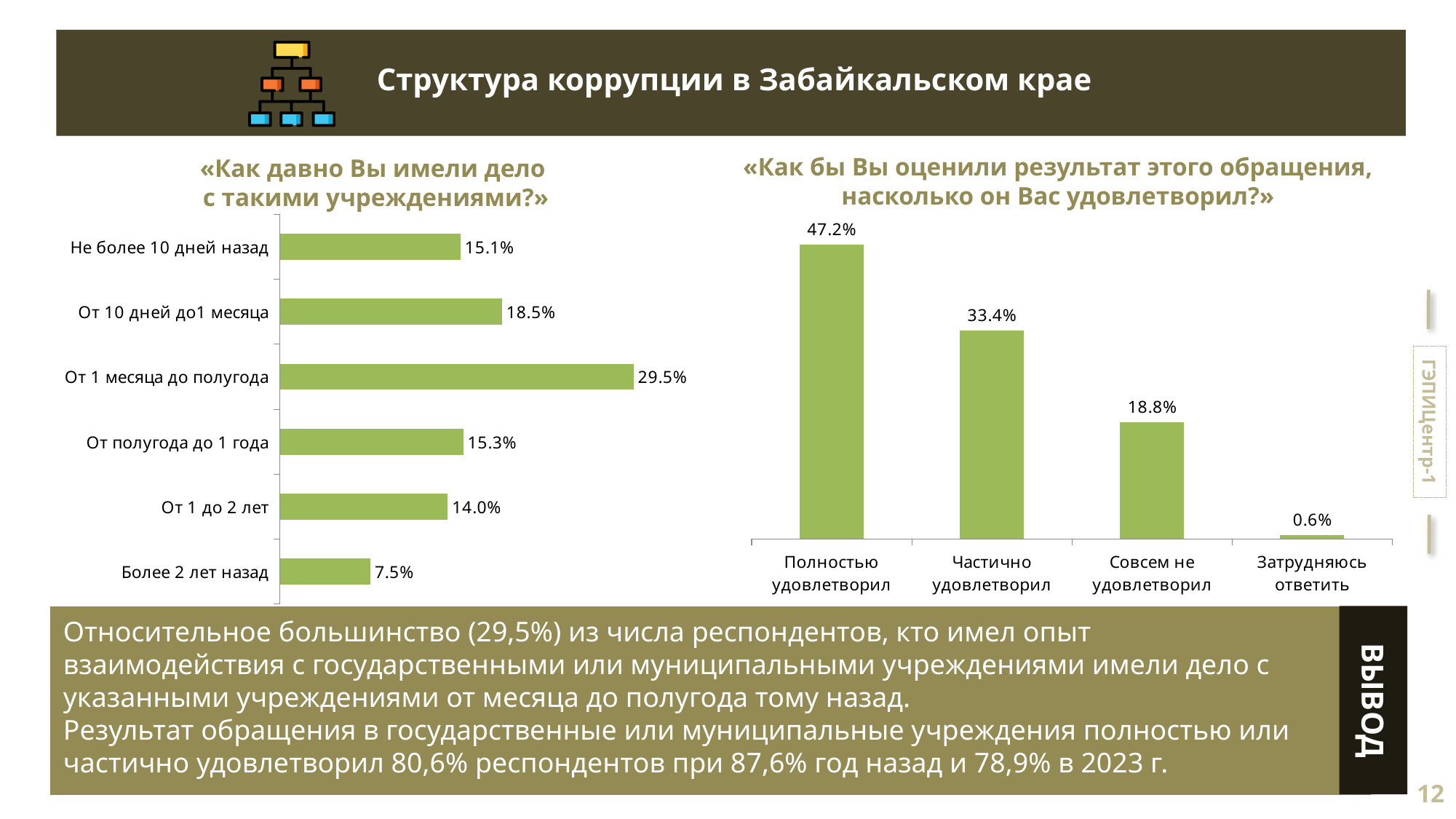
In the left chart «Как давно Вы имели дело с такими учреждениями?», how many categories are shown? 6 In the left chart «Как давно Вы имели дело с такими учреждениями?», what is the difference between «От 10 дней до1 месяца» and «Не более 10 дней назад»? 3.4% In the right chart «Как бы Вы оценили результат этого обращения, насколько он Вас удовлетворил?», do the values rise or fall from left to right? Fall In the right chart «Как бы Вы оценили результат этого обращения, насколько он Вас удовлетворил?», what is the value for «Затрудняюсь ответить»? 0.6% In the right chart «Как бы Вы оценили результат этого обращения, насколько он Вас удовлетворил?», what is the difference between «Полностью удовлетворил» and «Частично удовлетворил»? 13.8% In the right chart «Как бы Вы оценили результат этого обращения, насколько он Вас удовлетворил?», what is the value for «Полностью удовлетворил»? 47.2% In the left chart «Как давно Вы имели дело с такими учреждениями?», which category has the highest value? От 1 месяца до полугода In the left chart «Как давно Вы имели дело с такими учреждениями?», what is the value for «Более 2 лет назад»? 7.5% In the left chart «Как давно Вы имели дело с такими учреждениями?», which category has the lowest value? Более 2 лет назад What type of chart is the left chart «Как давно Вы имели дело с такими учреждениями?»? Bar chart In the left chart «Как давно Вы имели дело с такими учреждениями?», what is the value for «От 1 месяца до полугода»? 29.5% In the right chart «Как бы Вы оценили результат этого обращения, насколько он Вас удовлетворил?», which is larger: «Частично удовлетворил» or «Совсем не удовлетворил»? Частично удовлетворил